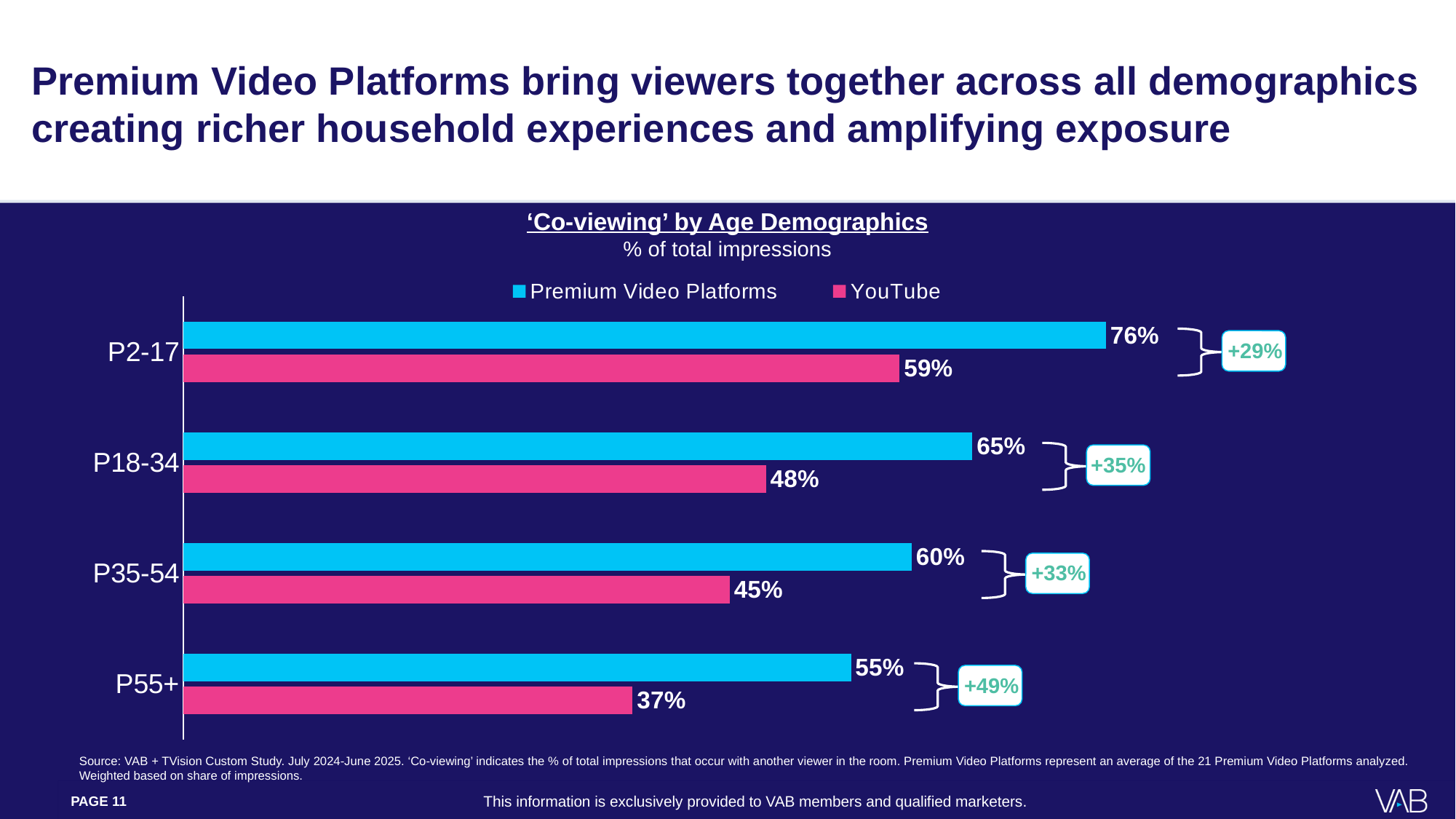
What is the co-viewing value for YouTube among P55+? 37% What is the difference between the Premium Video Platforms and YouTube values for P35-54? 15 percentage points What is the co-viewing value for Premium Video Platforms among P2-17? 76% Which is larger for P18-34: the Premium Video Platforms value or the YouTube value? Premium Video Platforms What is the co-viewing value for YouTube among P18-34? 48% How many age demographics are shown in the chart? 4 Do the Premium Video Platforms values rise or fall from P2-17 down to P55+? Fall Which age demographic has the highest Premium Video Platforms co-viewing value? P2-17 What kind of chart is shown on the slide? Bar chart What is the title of the chart? 'Co-viewing' by Age Demographics Which age demographic has the lowest YouTube co-viewing value? P55+ How many series does the legend list? 2